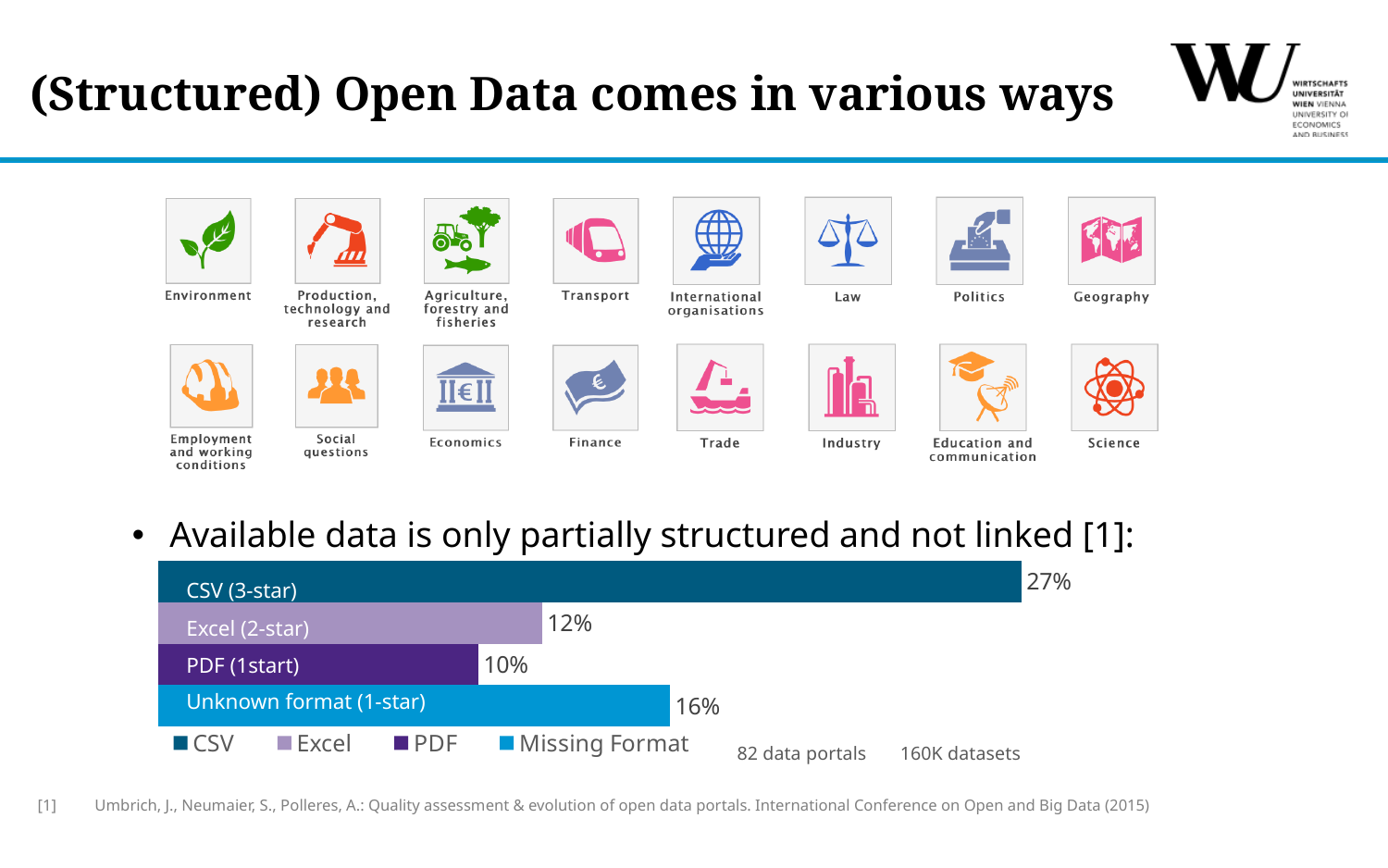
Which format has the highest value? CSV (3-star) What is the difference between the values for CSV (3-star) and Unknown format (1-star)? 11% Which is larger, the value for Excel (2-star) or Unknown format (1-star)? Unknown format (1-star) What kind of chart is shown on the slide? Bar chart How many entries does the chart legend list? 4 How many bars are shown in the chart? 4 What is the difference between the values for Excel (2-star) and PDF (1start)? 2% What is the value for PDF (1start)? 10% What is the value for CSV (3-star)? 27% Which format has the lowest value? PDF (1start) What is the value for Unknown format (1-star)? 16% What is the value for Excel (2-star)? 12%